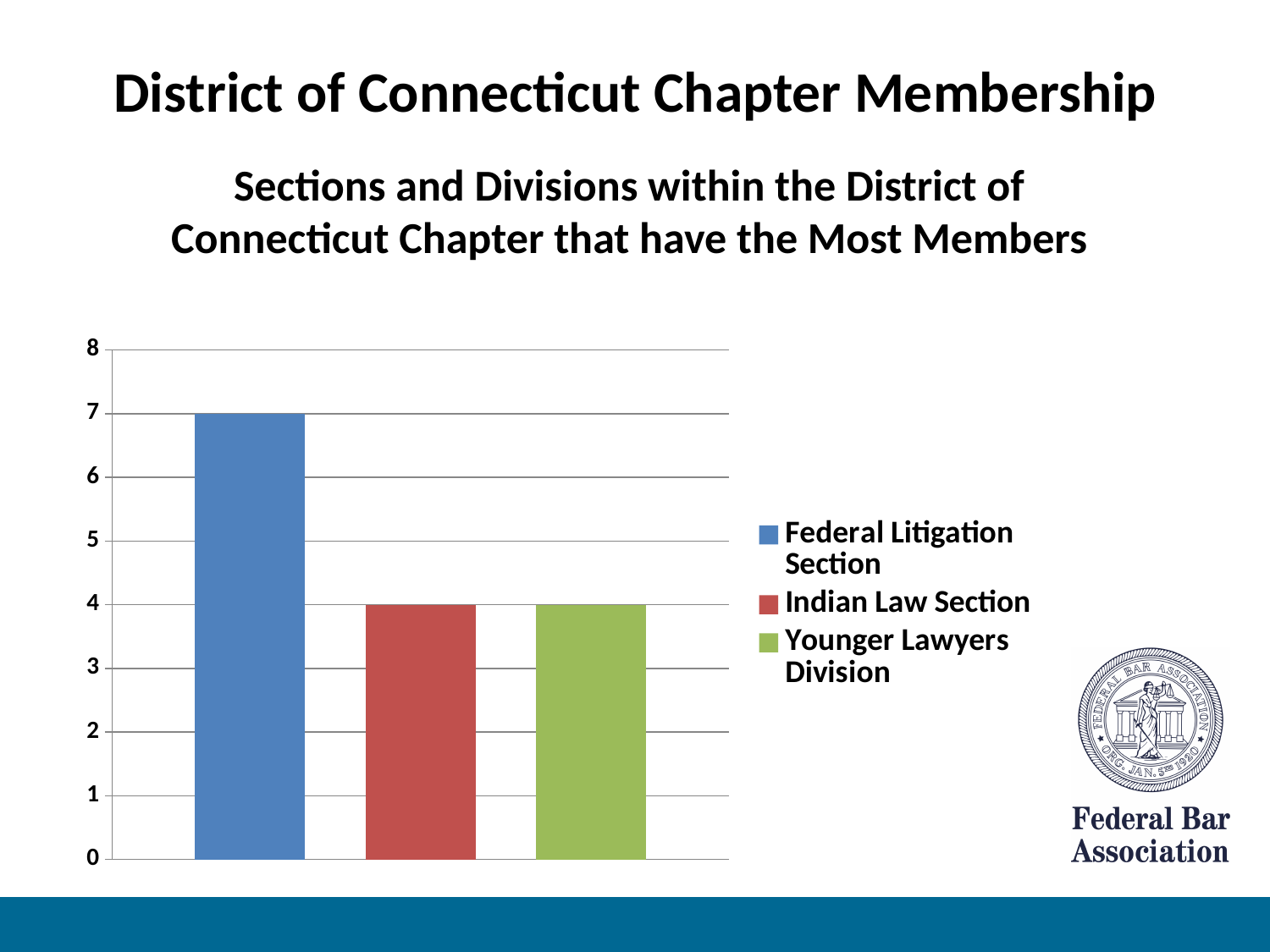
What colour is the bar for the Younger Lawyers Division? green What is the value for the Younger Lawyers Division? 4 How many entries does the legend list? 3 Is the value for the Federal Litigation Section greater or less than 5? greater How many bars are plotted in the chart? 3 What kind of chart is shown on the slide? bar chart Which section or division has the highest value? Federal Litigation Section Is the value for the Indian Law Section greater or less than 6? less Which is larger, the Federal Litigation Section or the Younger Lawyers Division? Federal Litigation Section What is the value for the Federal Litigation Section? 7 What is the value for the Indian Law Section? 4 What is the difference between the Federal Litigation Section and the Indian Law Section? 3